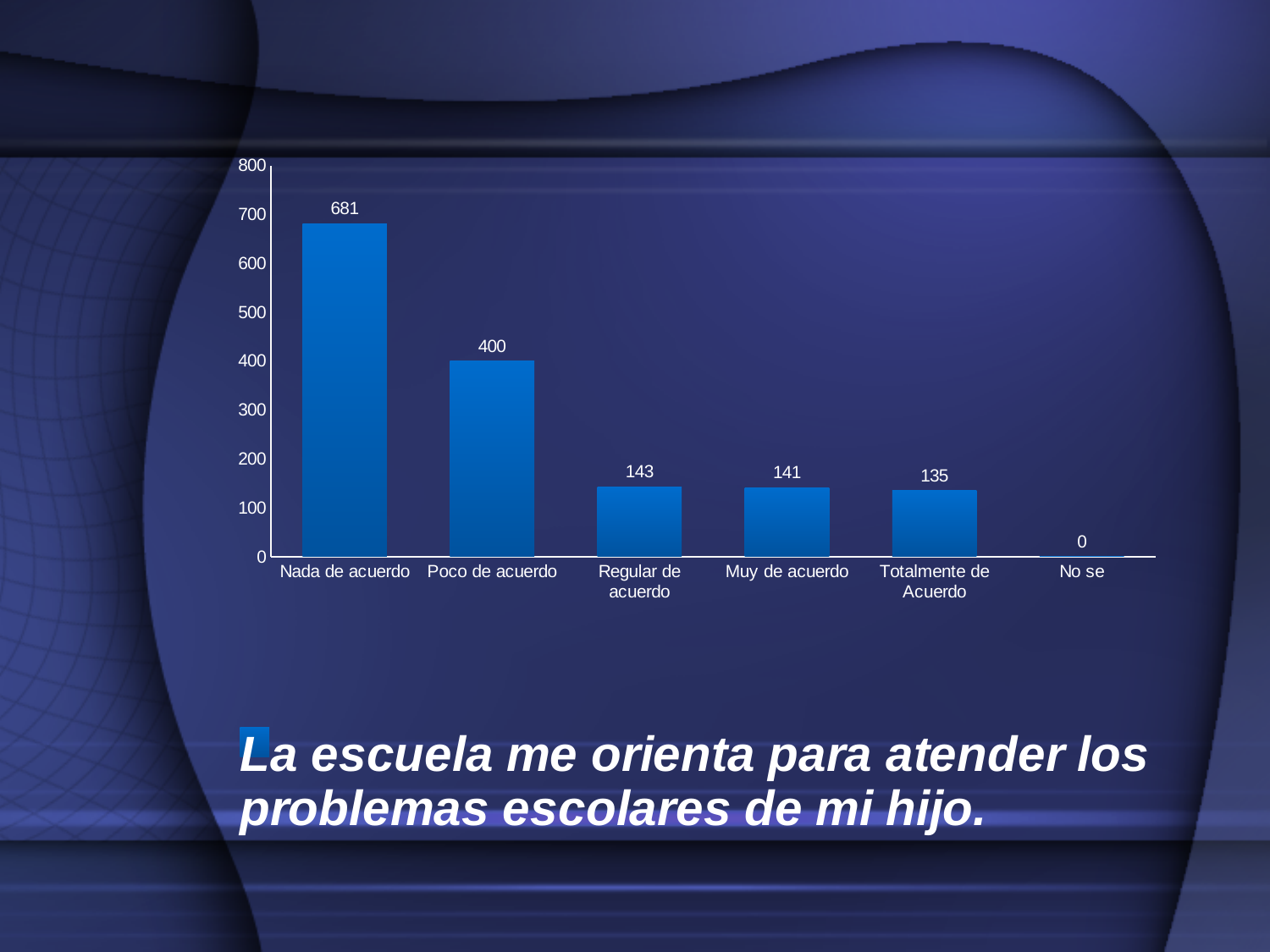
What is the value for No se? 0 Which is larger, the value for Poco de acuerdo or the value for Muy de acuerdo? Poco de acuerdo What is the value for Poco de acuerdo? 400 Do the values rise or fall from left to right along the x axis? Fall What kind of chart is shown on the slide? Bar chart What is the difference between the values for Nada de acuerdo and Poco de acuerdo? 281 What is the value for Regular de acuerdo? 143 What is the value for Totalmente de Acuerdo? 135 Which category has the lowest value? No se Which category has the highest value? Nada de acuerdo How many categories are shown on the x axis? 6 What is the value for Nada de acuerdo? 681